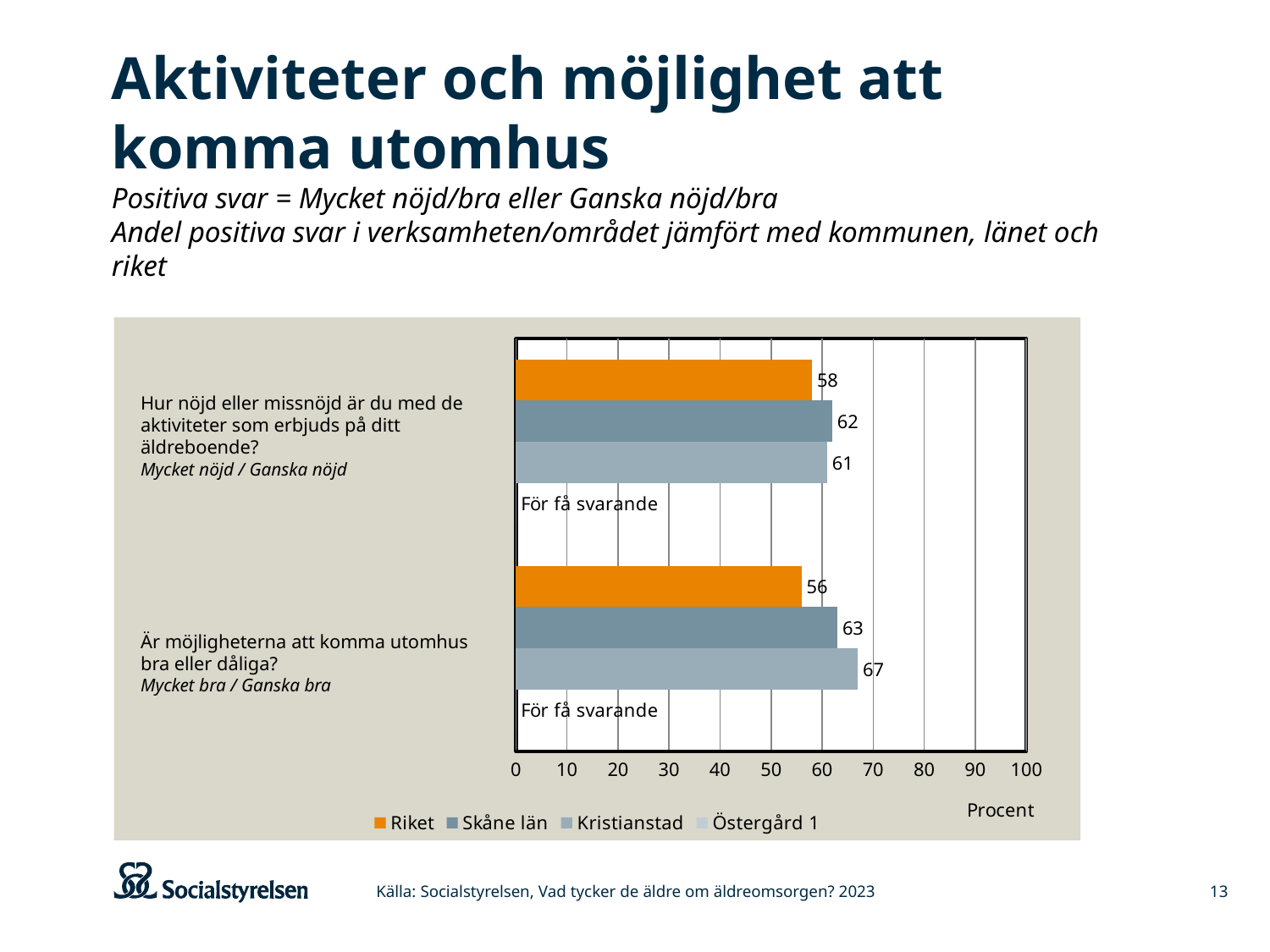
What is the value for Riket on the question about opportunities to get outdoors? 56 What is the value for Riket on the question about satisfaction with activities offered at the elderly home (Hur nöjd eller missnöjd är du med de aktiviteter som erbjuds på ditt äldreboende?)? 58 Which series has the lowest value on the question about satisfaction with activities offered? Riket What is the value for Skåne län on the question about satisfaction with activities offered at the elderly home? 62 Which series has the highest value on the question about opportunities to get outdoors? Kristianstad What is the label of the horizontal axis? Procent What kind of chart is shown on the slide? Bar chart Which is larger on the question about satisfaction with activities: Skåne län or Riket? Skåne län What is the value for Kristianstad on the question about whether the opportunities to get outdoors are good or bad (Är möjligheterna att komma utomhus bra eller dåliga?)? 67 How many series does the legend list? 4 What is the difference between Kristianstad and Riket on the question about opportunities to get outdoors? 11 What is shown for Östergård 1 instead of a bar on both questions? För få svarande